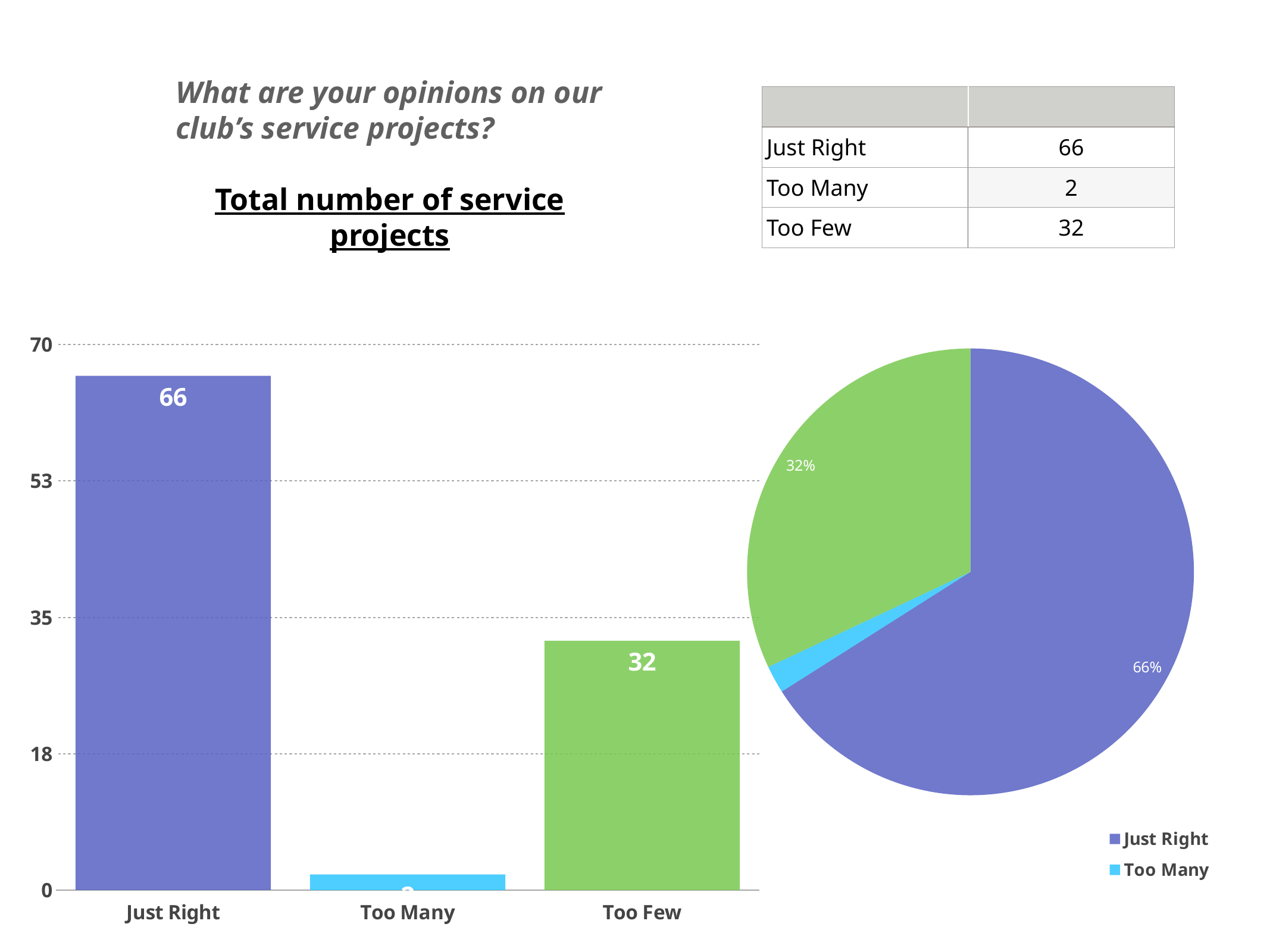
In the bar chart, what is the difference between the values for Just Right and Too Few? 34 In the bar chart, which is larger, the value for Too Few or the value for Too Many? Too Few In the bar chart, is the value for Too Many greater or less than 18? less In the pie chart, what share does the Just Right slice have? 66% In the bar chart, which category has the highest value? Just Right How many categories are shown in the bar chart? 3 In the bar chart, is the value for Just Right greater or less than 53? greater In the pie chart, what share does the green slice have? 32% What kind of chart is the chart on the left of the slide? bar chart In the bar chart, what is the value for Too Few? 32 In the bar chart, what is the value for Just Right? 66 In the bar chart, which category has the lowest value? Too Many